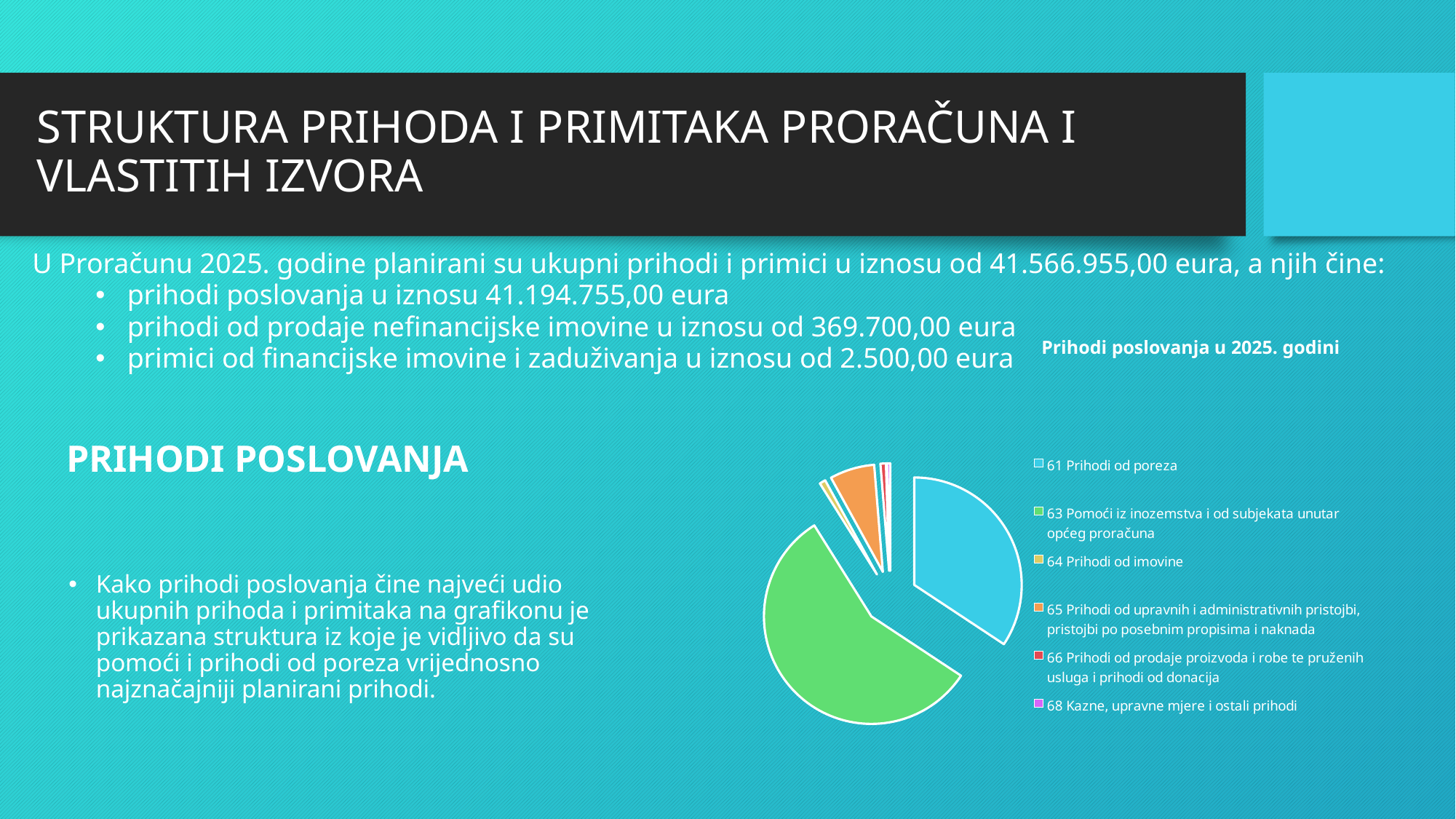
Which slice is larger in the pie chart: 65 Prihodi od upravnih i administrativnih pristojbi, pristojbi po posebnim propisima i naknada or 64 Prihodi od imovine? 65 Prihodi od upravnih i administrativnih pristojbi, pristojbi po posebnim propisima i naknada Which category has the largest slice in the pie chart? 63 Pomoći iz inozemstva i od subjekata unutar općeg proračuna How many categories does the legend of the pie chart list? 6 Which slice is larger in the pie chart: 61 Prihodi od poreza or 63 Pomoći iz inozemstva i od subjekata unutar općeg proračuna? 63 Pomoći iz inozemstva i od subjekata unutar općeg proračuna Which colour represents 61 Prihodi od poreza in the pie chart? blue What is the title of the chart on the slide? Prihodi poslovanja u 2025. godini What kind of chart is shown on the slide? pie chart Which slice is larger in the pie chart: 63 Pomoći iz inozemstva i od subjekata unutar općeg proračuna or 65 Prihodi od upravnih i administrativnih pristojbi, pristojbi po posebnim propisima i naknada? 63 Pomoći iz inozemstva i od subjekata unutar općeg proračuna